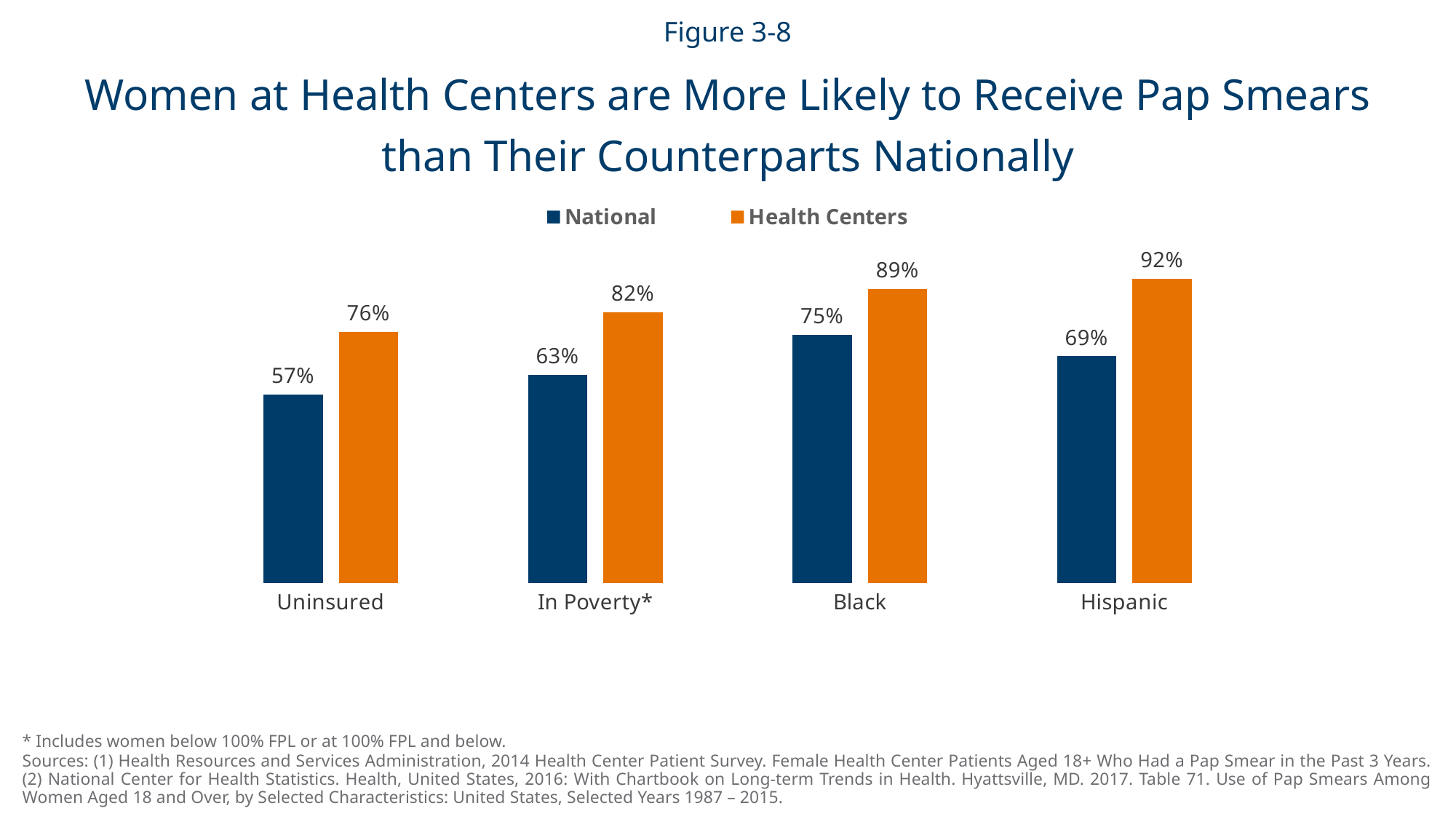
How many series does the legend list? 2 What is the Health Centers value for Black women? 89% What is the difference between the Health Centers and National values for Hispanic women? 23 percentage points What kind of chart is shown on the slide? Bar chart What is the National value for Uninsured women? 57% Which category has the lowest National value? Uninsured What is the difference between the Health Centers and National values for Uninsured women? 19 percentage points Which is larger, the National value for Black women or the National value for Hispanic women? Black Which category has the highest Health Centers value? Hispanic What is the Health Centers value for Hispanic women? 92% What is the National value for the In Poverty* category? 63% How many categories are shown on the x axis? 4